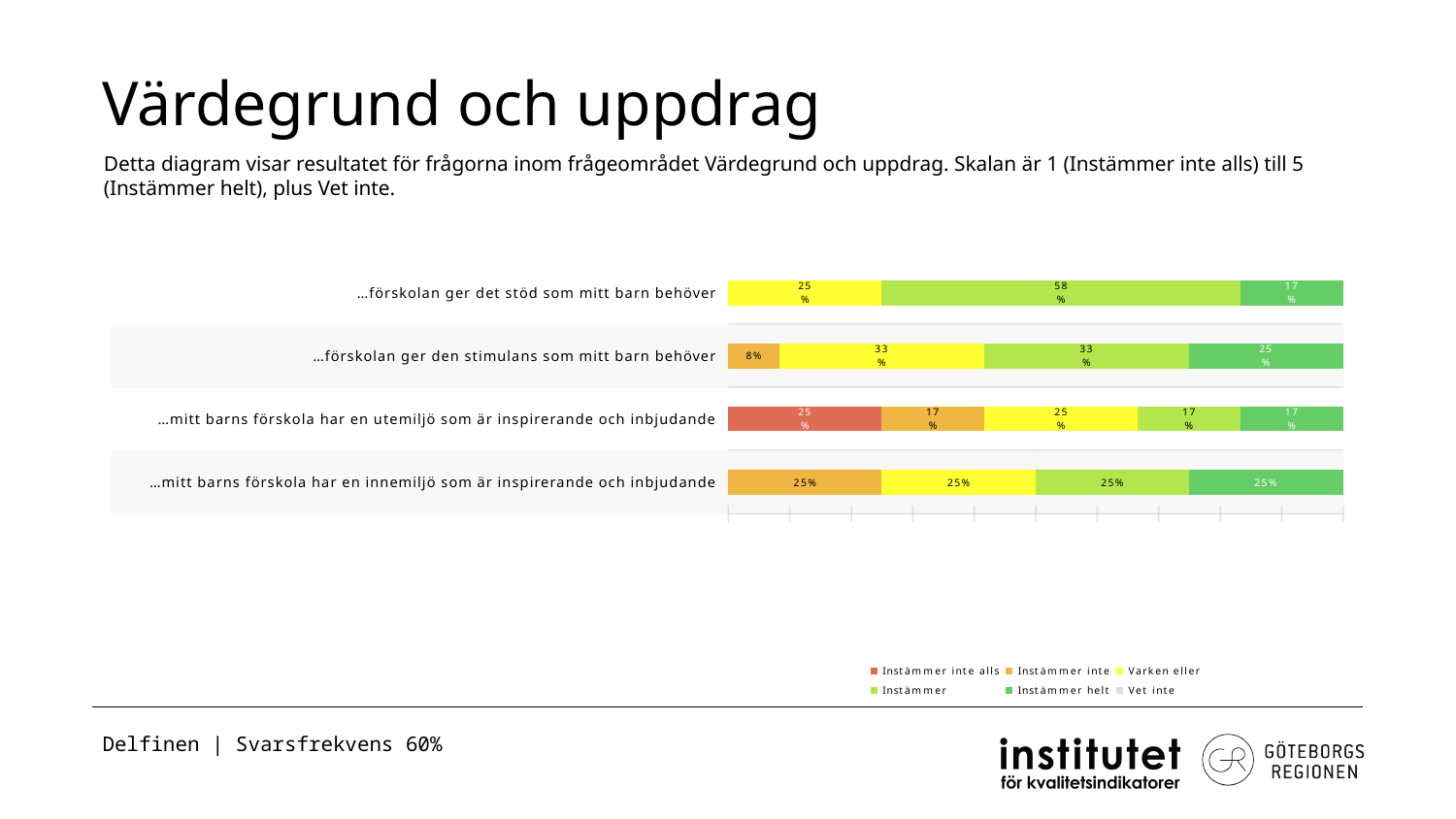
What is the 'Instämmer helt' share for '…förskolan ger det stöd som mitt barn behöver'? 17% What is the 'Instämmer inte alls' share for '…mitt barns förskola har en utemiljö som är inspirerande och inbjudande'? 25% How many statements (categories) are plotted in the chart? 4 What kind of chart is shown on the slide? Stacked bar chart What is the 'Instämmer inte' share for '…förskolan ger den stimulans som mitt barn behöver'? 8% Which legend entry is shown in red? Instämmer inte alls Which statement has the largest single segment in the chart? …förskolan ger det stöd som mitt barn behöver What is the 'Instämmer helt' share for '…mitt barns förskola har en innemiljö som är inspirerande och inbjudande'? 25% What is the difference between the 'Instämmer' share and the 'Instämmer helt' share for '…förskolan ger det stöd som mitt barn behöver'? 41% Which is larger for '…förskolan ger den stimulans som mitt barn behöver': the 'Instämmer helt' share or the 'Instämmer inte' share? Instämmer helt What is the 'Instämmer' share for '…förskolan ger det stöd som mitt barn behöver'? 58% How many series does the legend list? 6